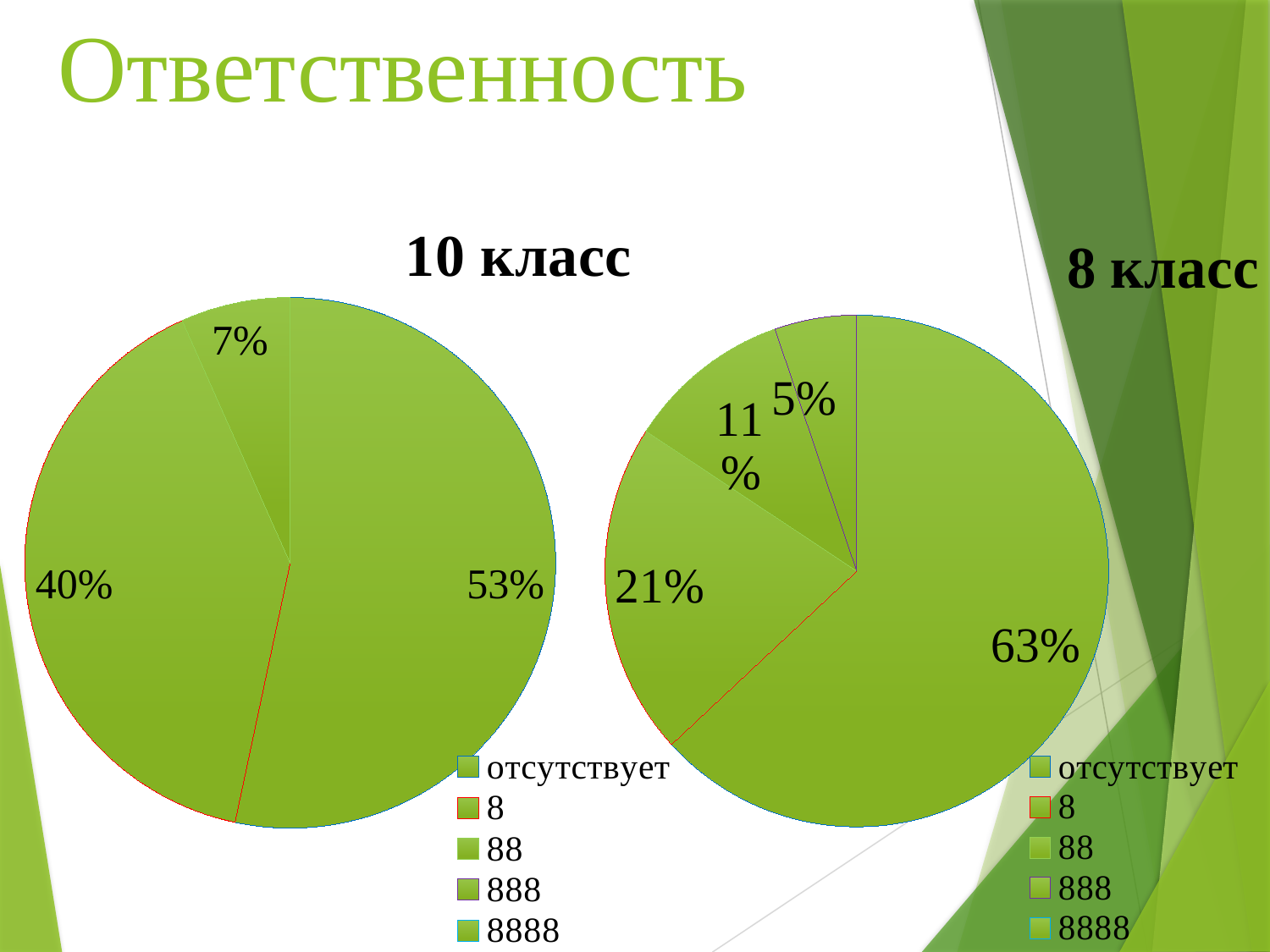
In the '10 класс' chart, what percentage is shown on the smallest slice? 7% In the '8 класс' chart, what is the difference between the 63% slice and the 21% slice? 42% What is the first entry in the legend of the '10 класс' chart? отсутствует What kind of chart is the '10 класс' chart? pie chart Which chart has the larger biggest slice, '10 класс' or '8 класс'? 8 класс In the '8 класс' chart, what percentage is shown on the largest slice? 63% In the '8 класс' chart, what percentage is shown on the smallest slice? 5% In the '10 класс' chart, what percentage is shown on the largest slice? 53% How many labelled slices does the '10 класс' pie chart have? 3 In the '10 класс' chart, what is the difference between the 53% slice and the 40% slice? 13% How many labelled slices does the '8 класс' pie chart have? 4 How many entries does the legend of the '8 класс' chart list? 5